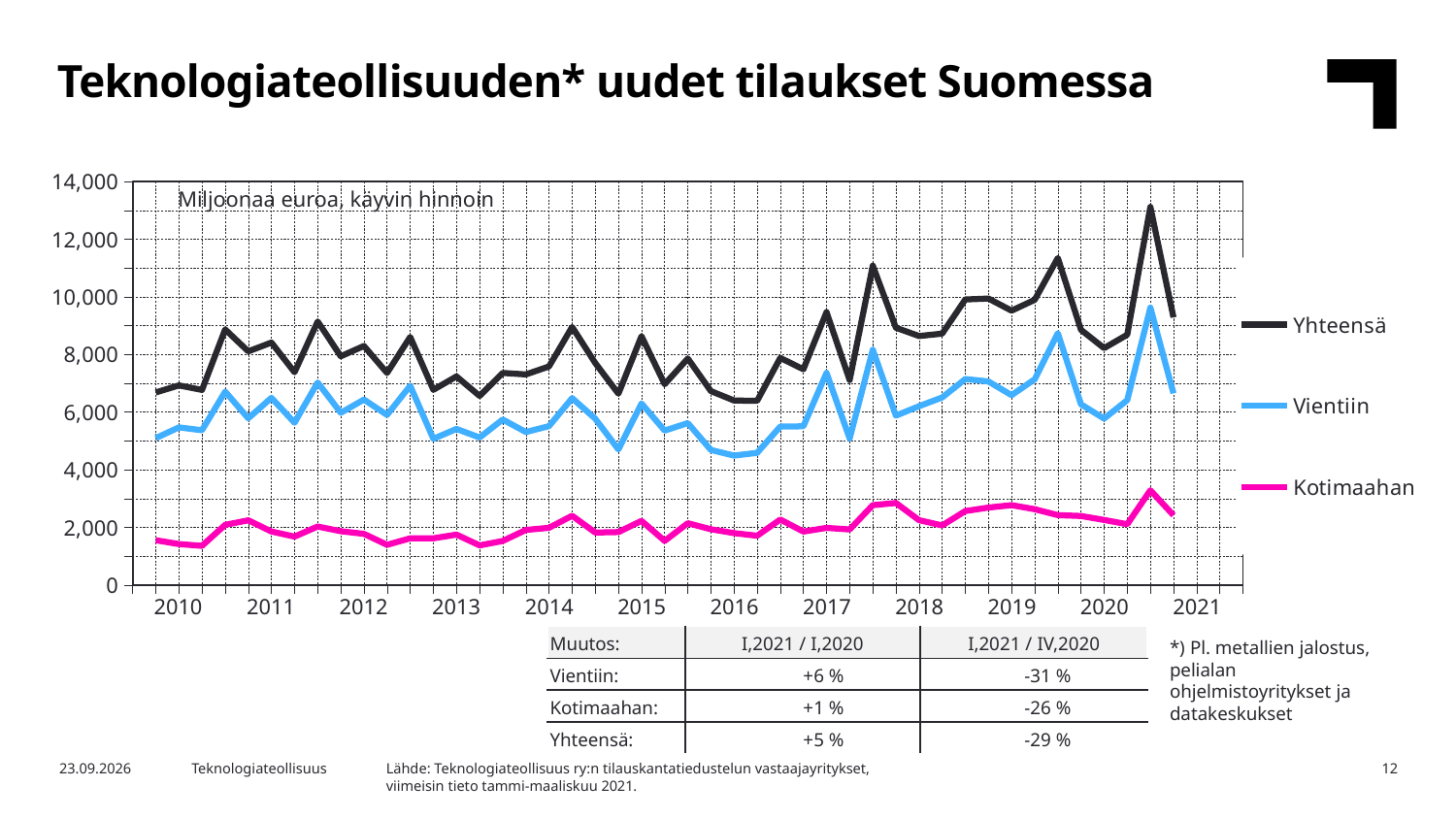
Which series has the highest values throughout the chart? Yhteensä How many series does the chart legend list? 3 Which series has the lowest values throughout the chart? Kotimaahan What are the three series named in the chart legend? Yhteensä, Vientiin, Kotimaahan Does the Yhteensä line rise or fall from its 2020 peak to the last point in 2021? fall Which is larger at the start of 2010: the Vientiin value or the Kotimaahan value? Vientiin Is the peak value of the Vientiin line in 2020 greater or less than 8,000? greater Is the Kotimaahan line ever greater or less than 4,000 across the whole chart? less What unit is stated in the chart's axis note? Miljoonaa euroa, käyvin hinnoin What kind of chart is shown on the slide? line chart Is the first value of the Kotimaahan line in 2010 greater or less than 2,000? less